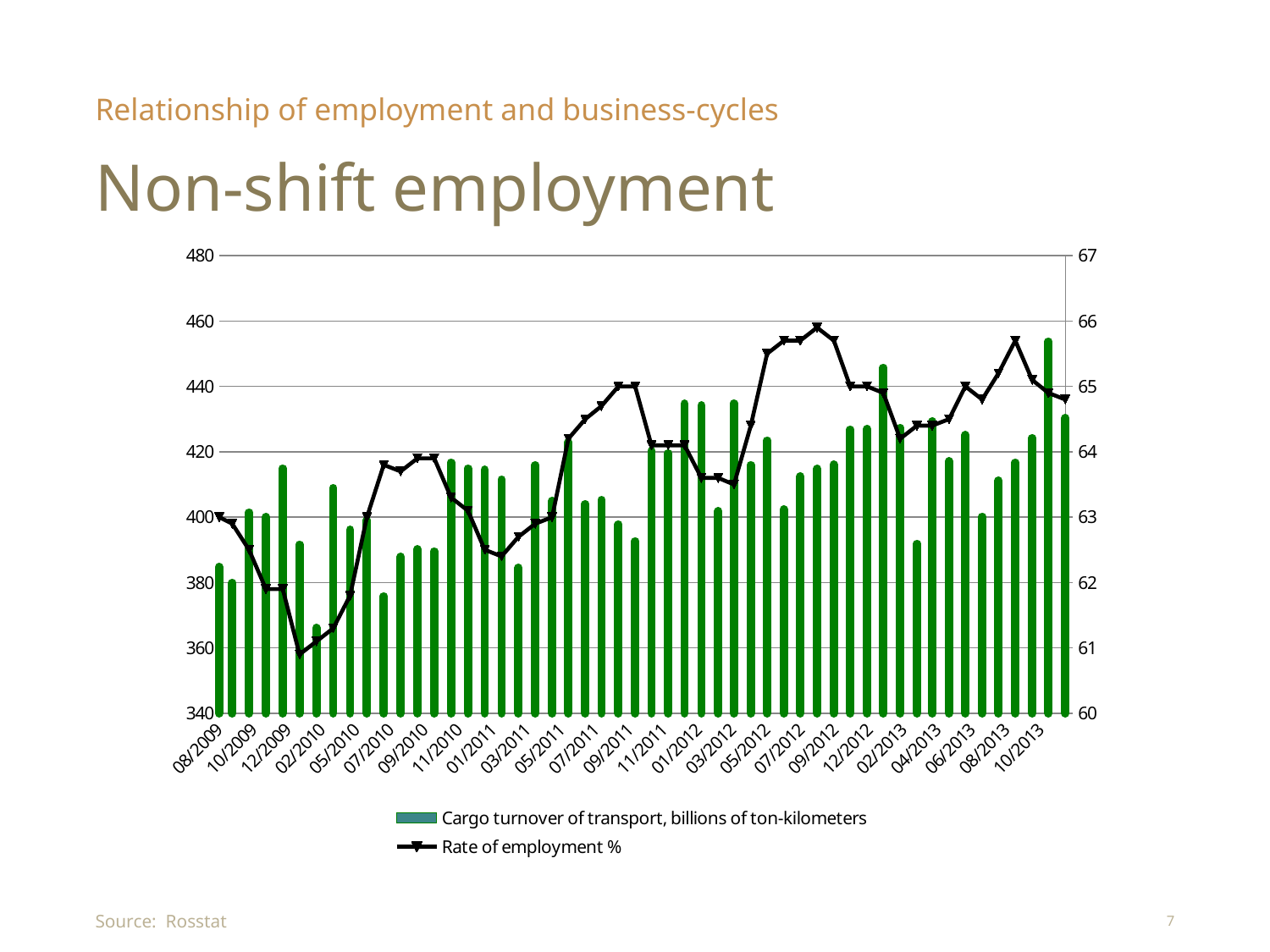
Is the cargo turnover of transport at 08/2009 greater or less than 400? less How many series does the legend list? 2 Is the rate of employment at 08/2009 greater or less than 62? greater In which year does the rate of employment reach its lowest point? 2010 Is the cargo turnover of transport at 10/2013 greater or less than 420? greater Which series is plotted as bars? Cargo turnover of transport, billions of ton-kilometers What is the source cited for the chart? Rosstat Overall, does the rate of employment rise or fall from 08/2009 to 10/2013? rise What kind of chart is shown on the slide? A combination of a bar chart and a line chart In which year does the rate of employment reach its highest point? 2012